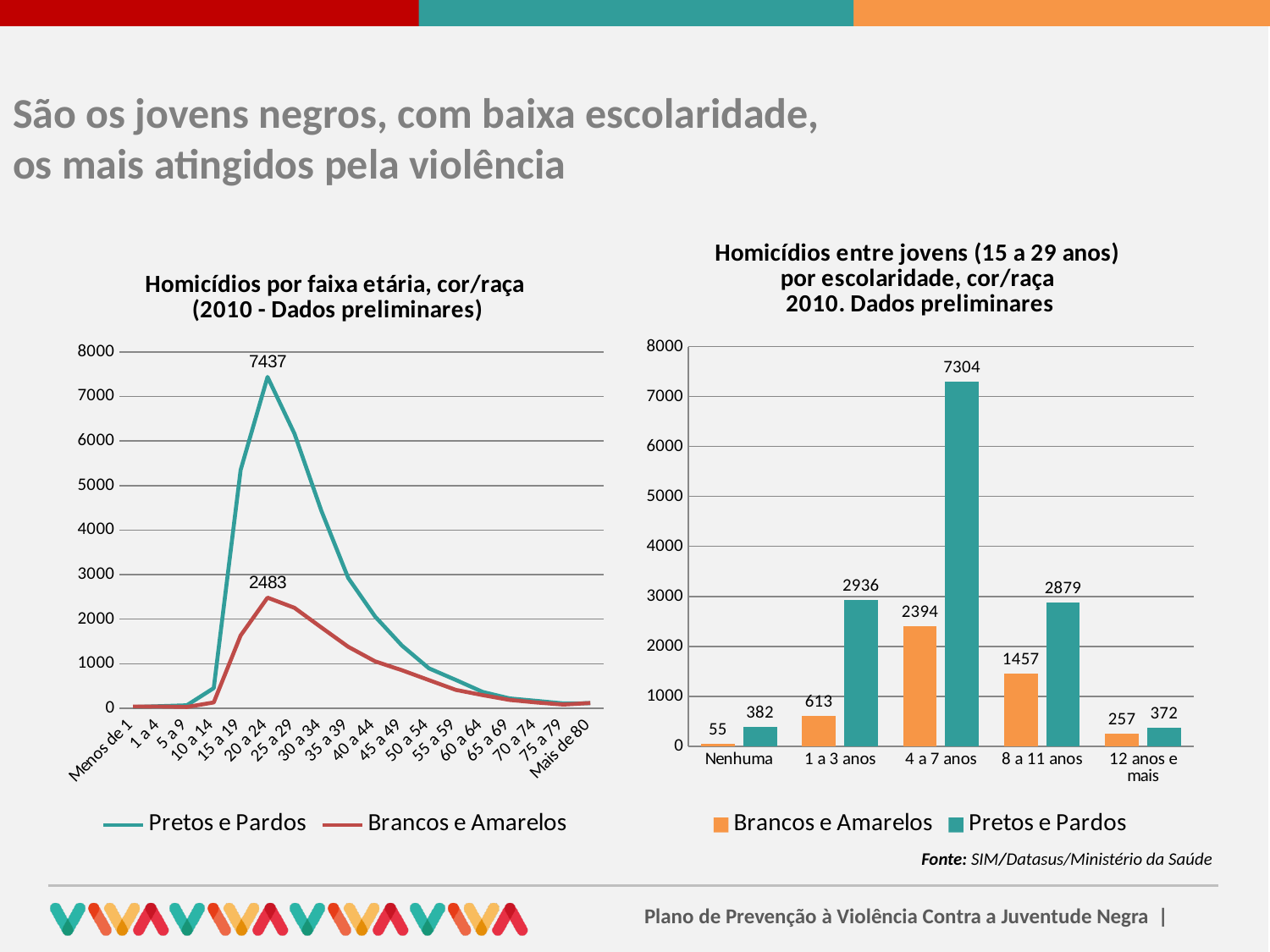
In the chart 'Homicídios por faixa etária, cor/raça', what is the peak value labelled for the Brancos e Amarelos series? 2483 In the chart 'Homicídios por faixa etária, cor/raça', which age group has the highest value for Pretos e Pardos? 20 a 24 In the chart 'Homicídios por faixa etária, cor/raça', do the values for Pretos e Pardos rise or fall from '20 a 24' to 'Mais de 80'? Fall In the chart 'Homicídios por faixa etária, cor/raça', what is the difference between the labelled peaks of Pretos e Pardos and Brancos e Amarelos? 4954 In the chart 'Homicídios entre jovens (15 a 29 anos) por escolaridade', which schooling category has the lowest value for Brancos e Amarelos? Nenhuma In the chart 'Homicídios entre jovens (15 a 29 anos) por escolaridade', what is the value for Brancos e Amarelos with '8 a 11 anos' of schooling? 1457 In the chart 'Homicídios por faixa etária, cor/raça', how many age groups are shown on the x axis? 18 In the chart 'Homicídios entre jovens (15 a 29 anos) por escolaridade', which is larger for '12 anos e mais': Brancos e Amarelos or Pretos e Pardos? Pretos e Pardos In the chart 'Homicídios por faixa etária, cor/raça', what is the peak value labelled for the Pretos e Pardos series? 7437 What kind of chart is 'Homicídios por faixa etária, cor/raça'? Line chart In the chart 'Homicídios entre jovens (15 a 29 anos) por escolaridade', what is the value for Pretos e Pardos with '4 a 7 anos' of schooling? 7304 In the chart 'Homicídios entre jovens (15 a 29 anos) por escolaridade', what is the difference between Pretos e Pardos and Brancos e Amarelos for '1 a 3 anos'? 2323